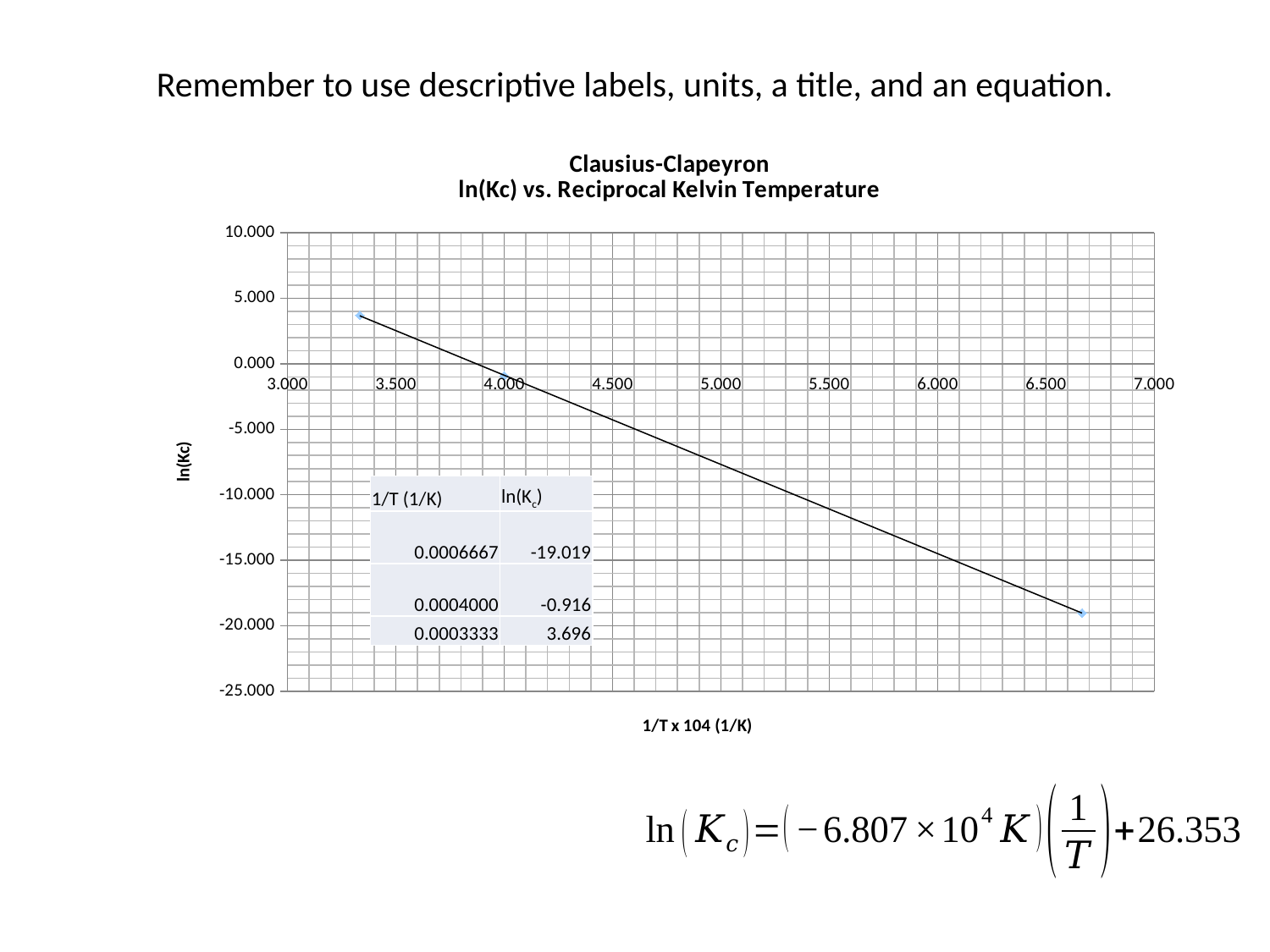
Is the ln(Kc) value of the rightmost plotted point greater or less than -15.000? less What kind of chart is shown on the slide? scatter chart with a trend line According to the data table on the chart, what is ln(Kc) when 1/T is 0.0006667 1/K? -19.019 How many data points are plotted on the chart? 3 Which 1/T value in the data table has the highest ln(Kc)? 0.0003333 According to the data table on the chart, what is ln(Kc) when 1/T is 0.0004000 1/K? -0.916 Which is larger, the ln(Kc) value at 1/T = 0.0004000 or at 1/T = 0.0006667? 0.0004000 Do the ln(Kc) values rise or fall as 1/T increases along the x axis? fall What is the title of the chart? Clausius-Clapeyron ln(Kc) vs. Reciprocal Kelvin Temperature Which 1/T value in the data table has the lowest ln(Kc)? 0.0006667 According to the data table on the chart, what is ln(Kc) when 1/T is 0.0003333 1/K? 3.696 What is the difference between the ln(Kc) values at 1/T = 0.0003333 and 1/T = 0.0004000? 4.612